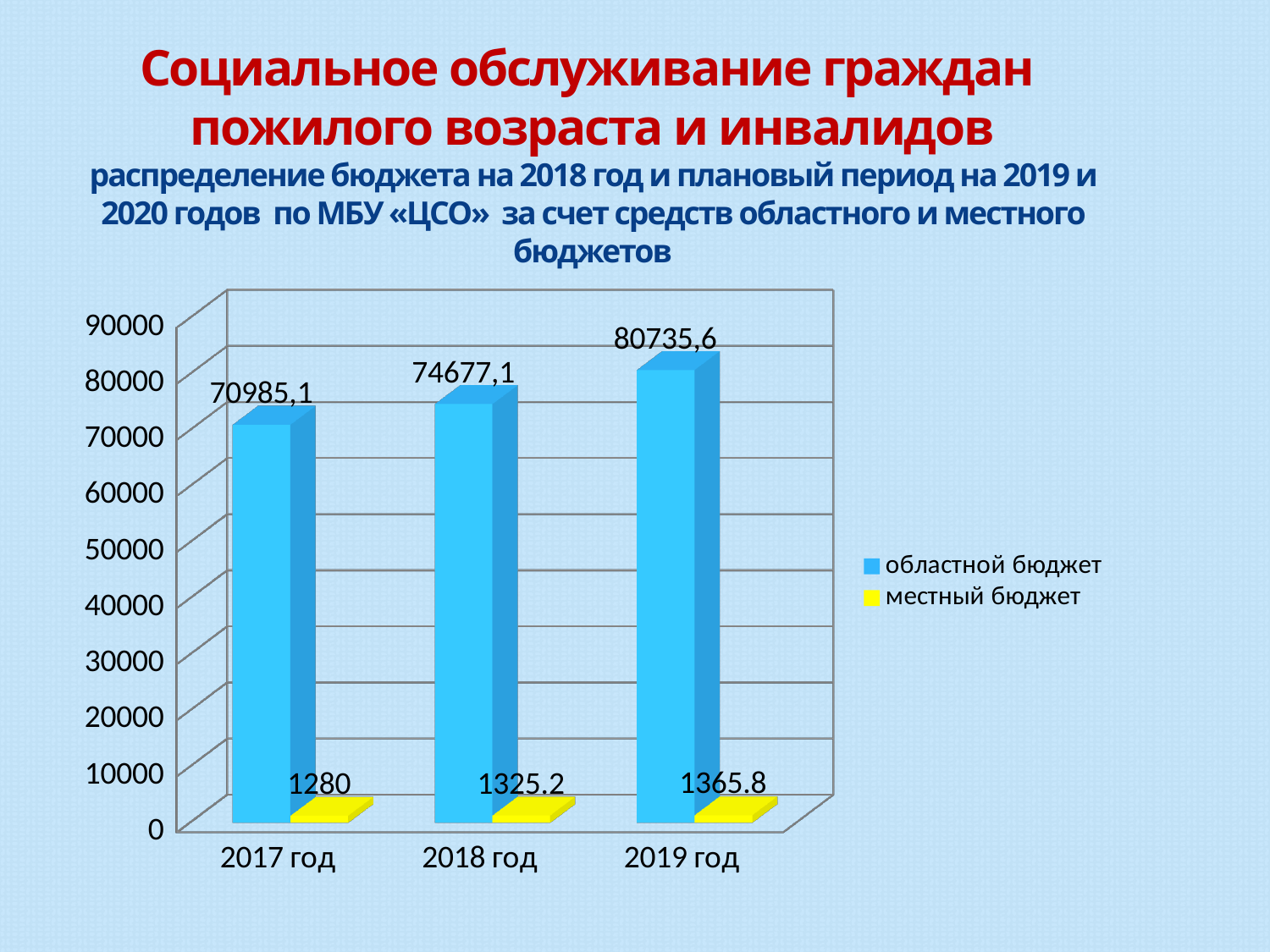
In which year is областной бюджет the highest? 2019 год What is the value of местный бюджет for 2017 год? 1280 What is the value of областной бюджет for 2017 год? 70985,1 Which is larger: областной бюджет in 2018 год or in 2019 год? 2019 год How many series does the legend list? 2 In which year is местный бюджет the lowest? 2017 год Does областной бюджет rise or fall from 2017 год to 2019 год? rise Is the value of областной бюджет for 2017 год greater or less than 80000? less What is the value of областной бюджет for 2018 год? 74677,1 What is the value of местный бюджет for 2019 год? 1365.8 What is the difference between областной бюджет in 2019 год and in 2017 год? 9750,5 What is the difference between местный бюджет in 2018 год and in 2017 год? 45.2